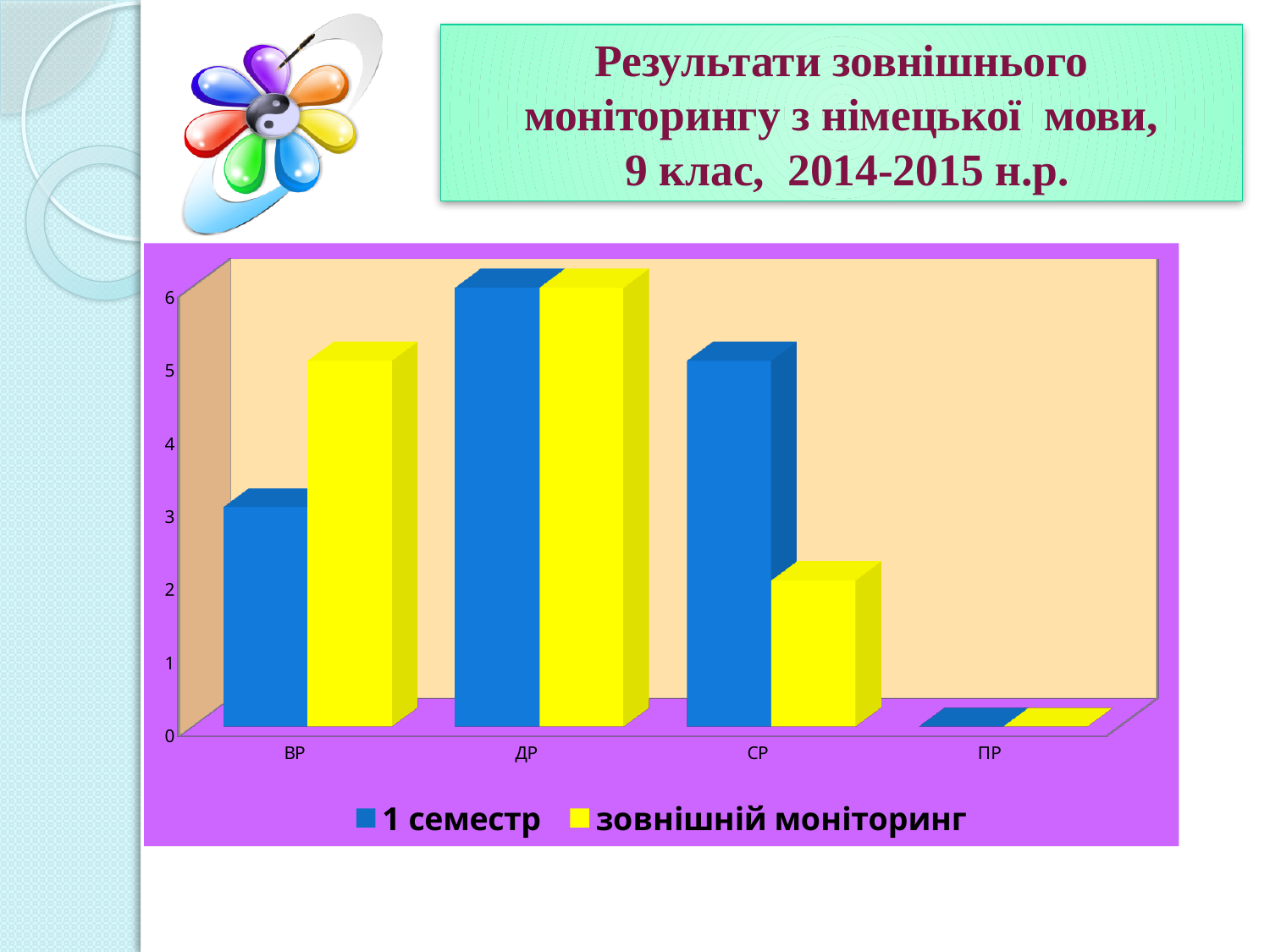
Which category has the lowest value for the series "1 семестр"? ПР For the category ВР, which series has the larger value: "1 семестр" or "зовнішній моніторинг"? зовнішній моніторинг What kind of chart is shown on the slide? bar chart Which category has the highest value for the series "1 семестр"? ДР Is the value for ВР in the series "1 семестр" greater or less than 4? less For the category СР, which series has the larger value: "1 семестр" or "зовнішній моніторинг"? 1 семестр Which category has the lowest value for the series "зовнішній моніторинг"? ПР Is the value for СР in the series "зовнішній моніторинг" greater or less than 3? less Which colour represents the series "1 семестр" in the chart? blue How many categories are shown on the x axis of the chart? 4 How many series does the chart legend list? 2 Is the value for ДР in the series "1 семестр" greater or less than 5? greater